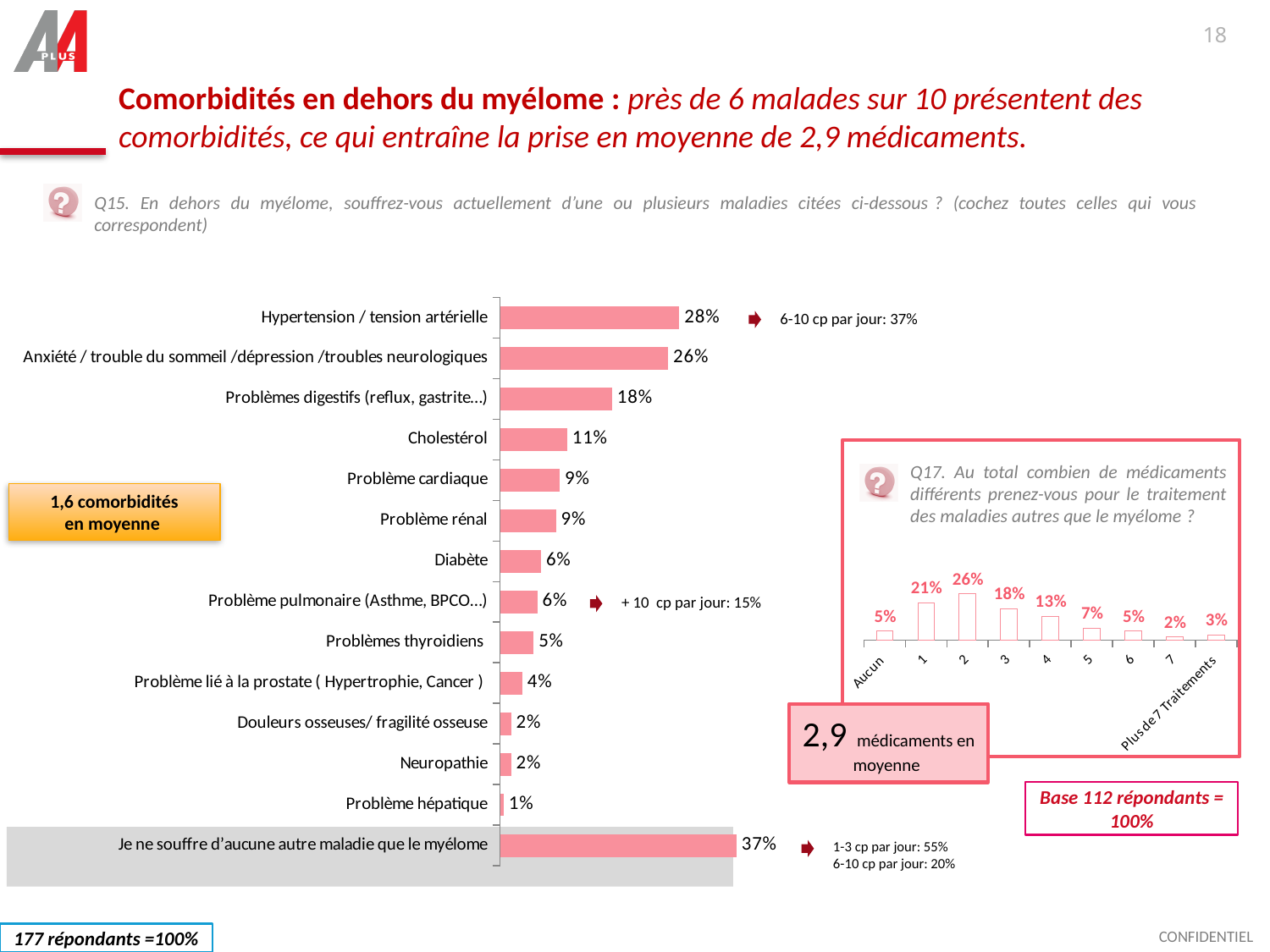
What kind of chart is the large chart on the left (Q15)? Bar chart In the small Q17 chart on the right, which category has the highest value? 2 In the large horizontal bar chart on the left (Q15), what is the difference between Hypertension / tension artérielle and Cholestérol? 17% In the large horizontal bar chart on the left (Q15), which category has the lowest value? Problème hépatique In the large horizontal bar chart on the left (Q15), which is larger: Diabète or Problèmes thyroidiens? Diabète In the large horizontal bar chart on the left (Q15), what is the value for Hypertension / tension artérielle? 28% How many categories are shown in the large horizontal bar chart on the left (Q15)? 14 In the small Q17 chart on the right, what is the difference between the values for 1 and 3? 3% In the small Q17 chart on the right, what is the value for 2 medications? 26% In the large horizontal bar chart on the left (Q15), which category has the highest value? Je ne souffre d'aucune autre maladie que le myélome How many categories are shown in the small Q17 chart on the right? 9 In the large horizontal bar chart on the left (Q15), what is the value for Problèmes digestifs (reflux, gastrite…)? 18%